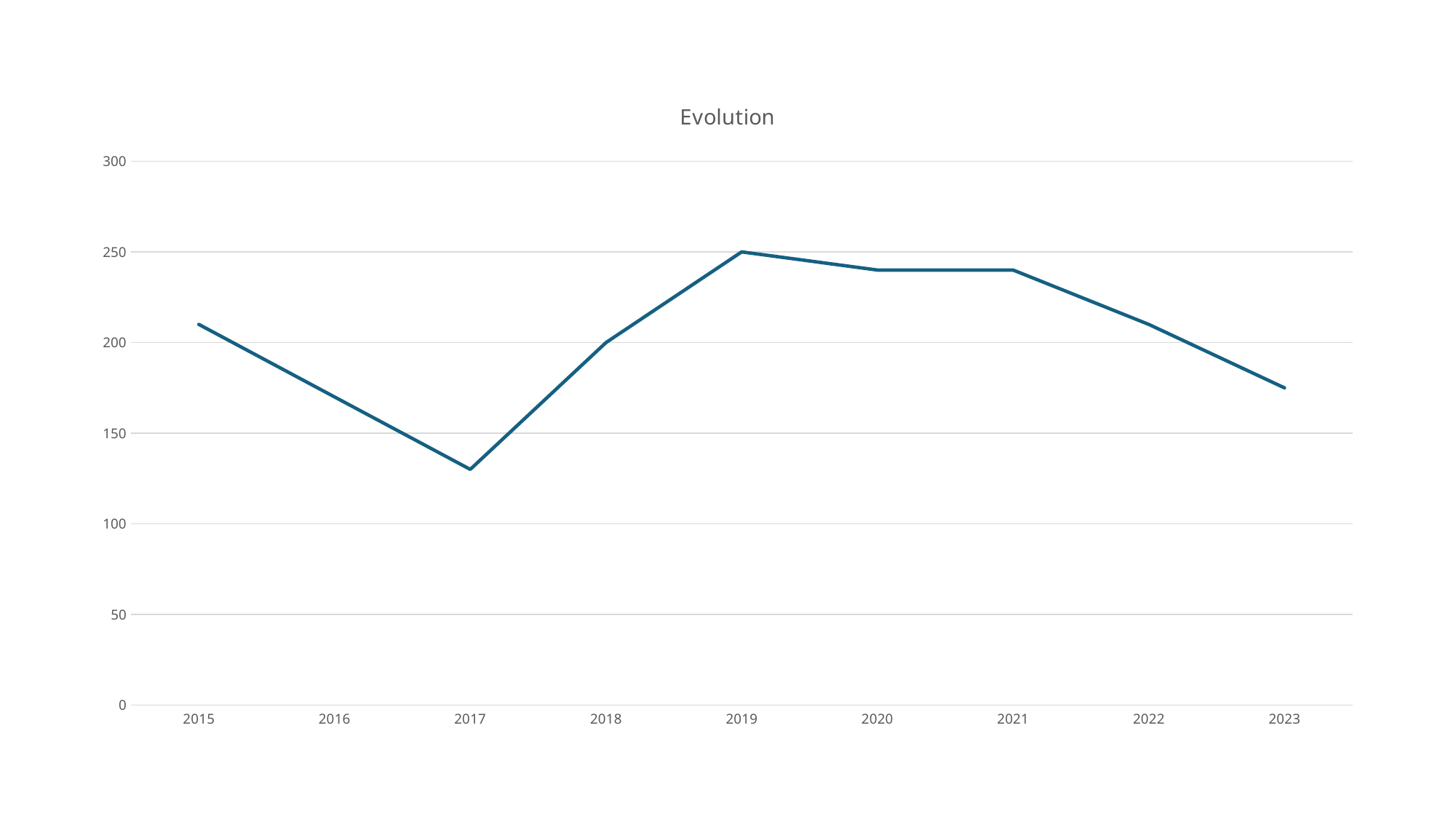
How many years are plotted on the x axis? 9 What kind of chart is shown on the slide? line chart Is the value for 2017 greater or less than 150? less What is the difference between the values for 2019 and 2018? 50 What is the value for 2018? 200 What is the value for 2019? 250 Which year has the highest value? 2019 What is the title of the chart? Evolution Which is larger, the value for 2015 or the value for 2023? 2015 Which year has the lowest value? 2017 Does the line rise or fall from 2015 to 2017? fall Is the value for 2015 greater or less than 200? greater